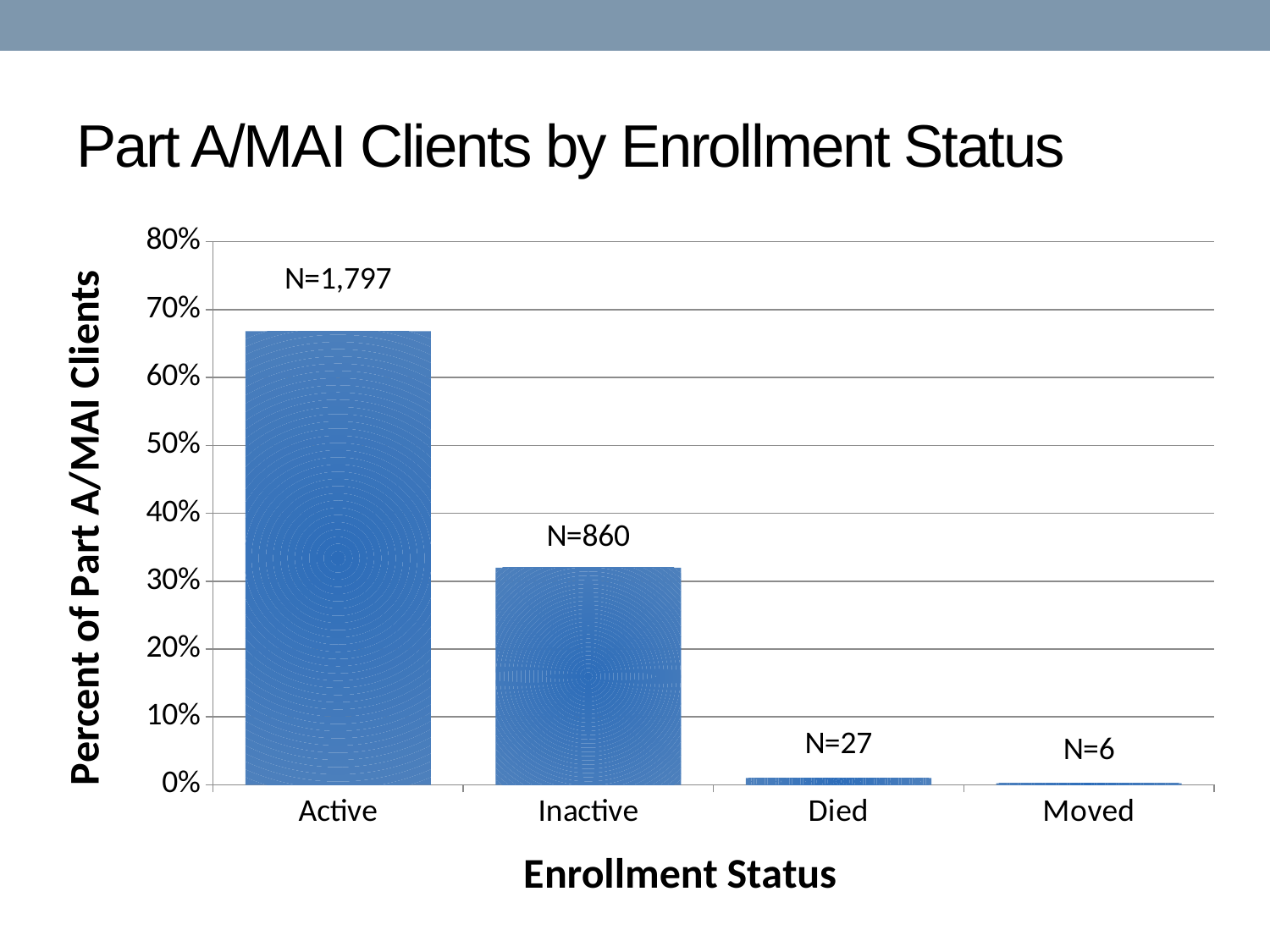
Which has a larger percentage of clients, Inactive or Died? Inactive Is the percentage for Active greater or less than 60%? greater Is the percentage for Inactive greater or less than 40%? less What is the data label shown above the Died bar? N=27 What is the data label shown above the Moved bar? N=6 Which enrollment status has the highest percentage of Part A/MAI clients? Active What is the data label shown above the Inactive bar? N=860 What type of chart is shown on the slide? Bar chart How many enrollment status categories are shown on the x axis? 4 What is the data label shown above the Active bar? N=1,797 Is the percentage for Died greater or less than 10%? less Which enrollment status has the lowest percentage of Part A/MAI clients? Moved